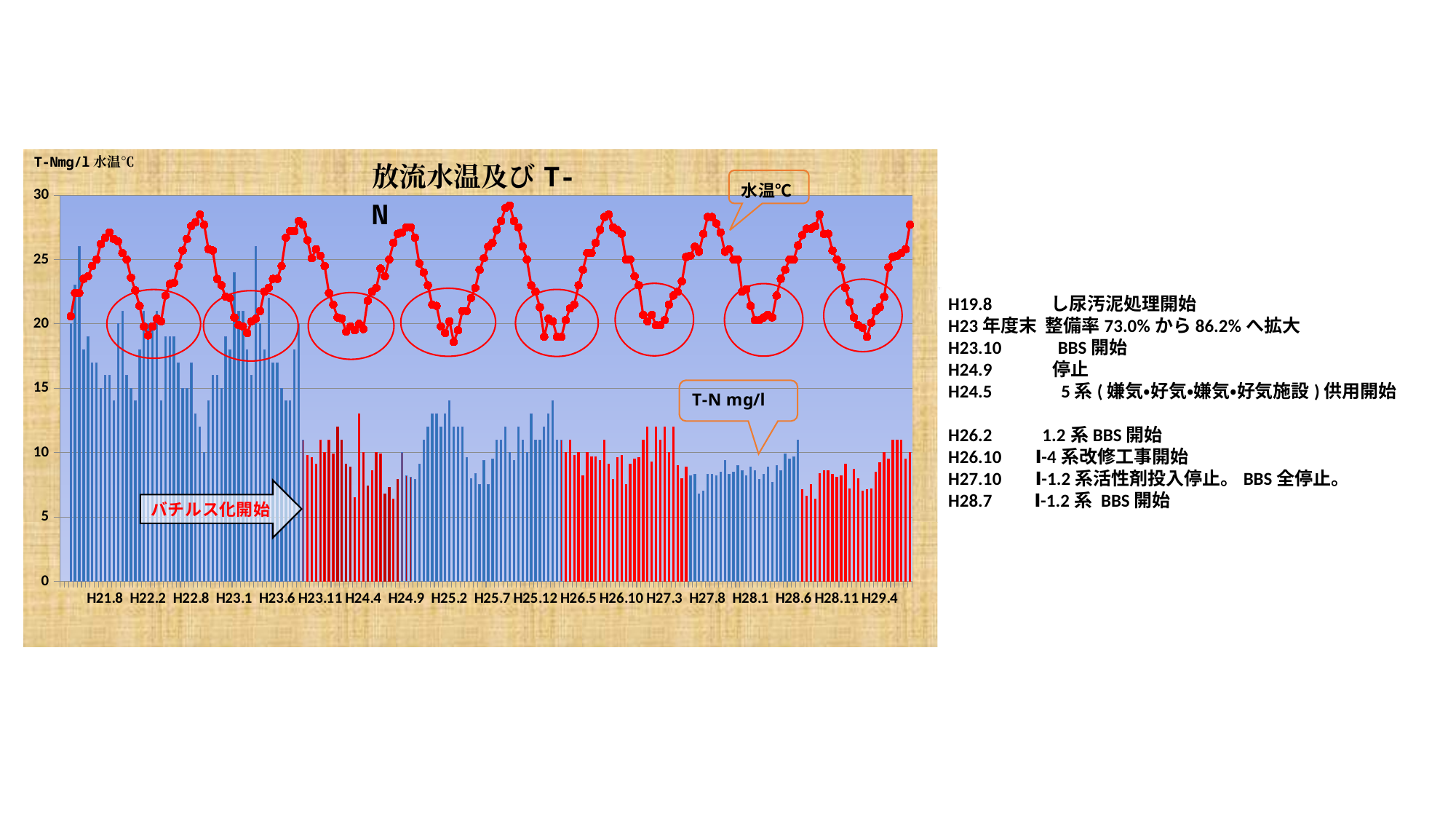
What kind of chart is shown on the slide? A combination of a bar chart and a line chart Which series is plotted as the red line with markers, according to the callout label? 水温℃ Are the T-N mg/l bars around H29.4 greater or less than 15? less What is the title of the chart? 放流水温及び T-N How many labels are shown on the x axis of the chart? 19 Do the T-N mg/l bars generally rise or fall from the left of the chart to the right? fall Is the lowest value of the 水温℃ line greater or less than 25? less What is the maximum value shown on the y axis? 30 Is the lowest value of the 水温℃ line greater or less than 15? greater